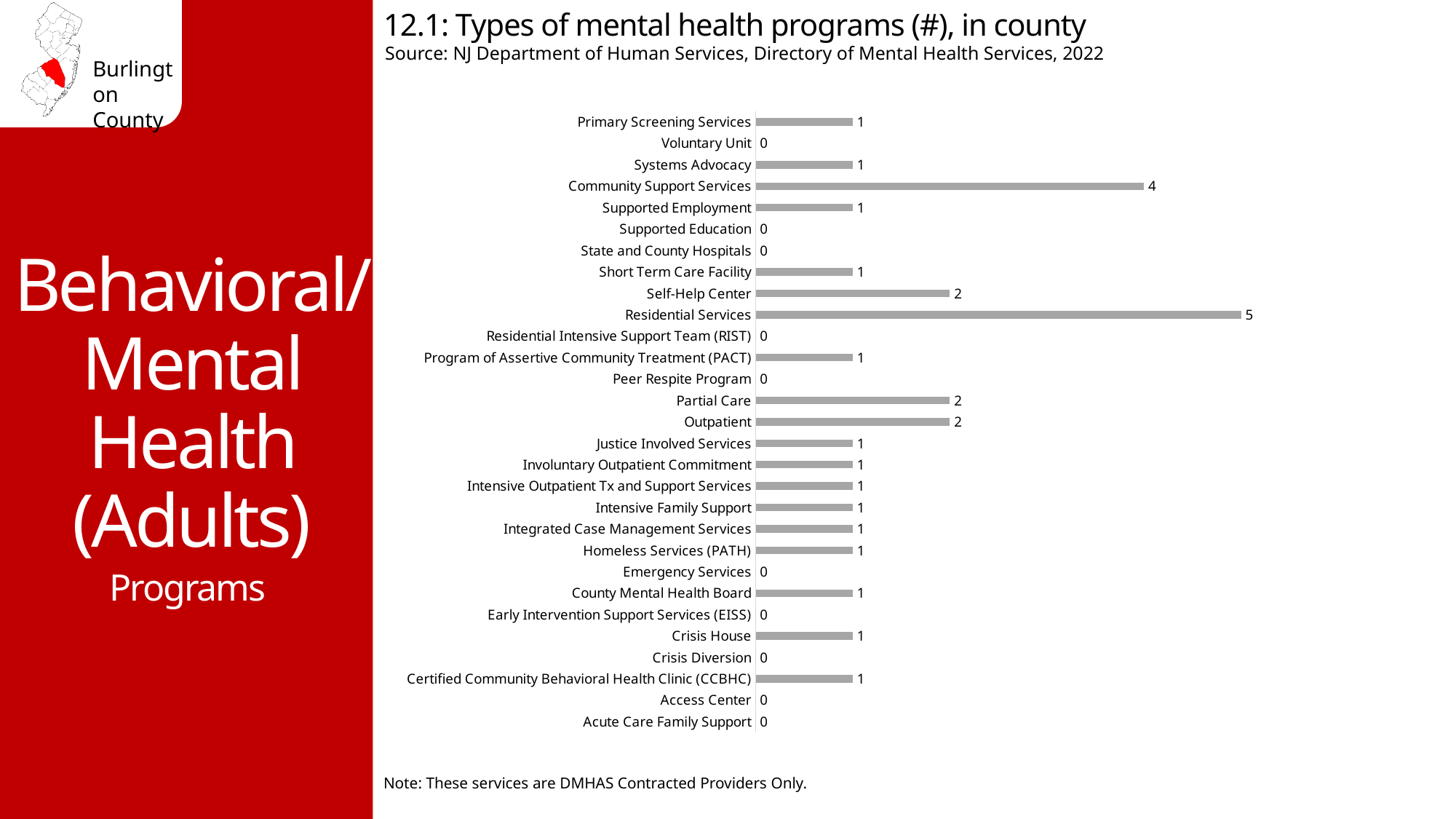
Which has a larger count, Partial Care or Supported Employment? Partial Care What value is shown for Voluntary Unit? 0 What is the number of Community Support Services programs? 4 What kind of chart is used on this slide? Bar chart How many Self-Help Center programs are shown? 2 What is the title of the chart? 12.1: Types of mental health programs (#), in county What is the number of Residential Services programs in the county? 5 How many program types are listed on the chart? 29 What is the source cited for the chart data? NJ Department of Human Services, Directory of Mental Health Services, 2022 What is the difference between the counts for Residential Services and Community Support Services? 1 What is the difference between the counts for Outpatient and Crisis House? 1 Which type of mental health program has the highest count? Residential Services